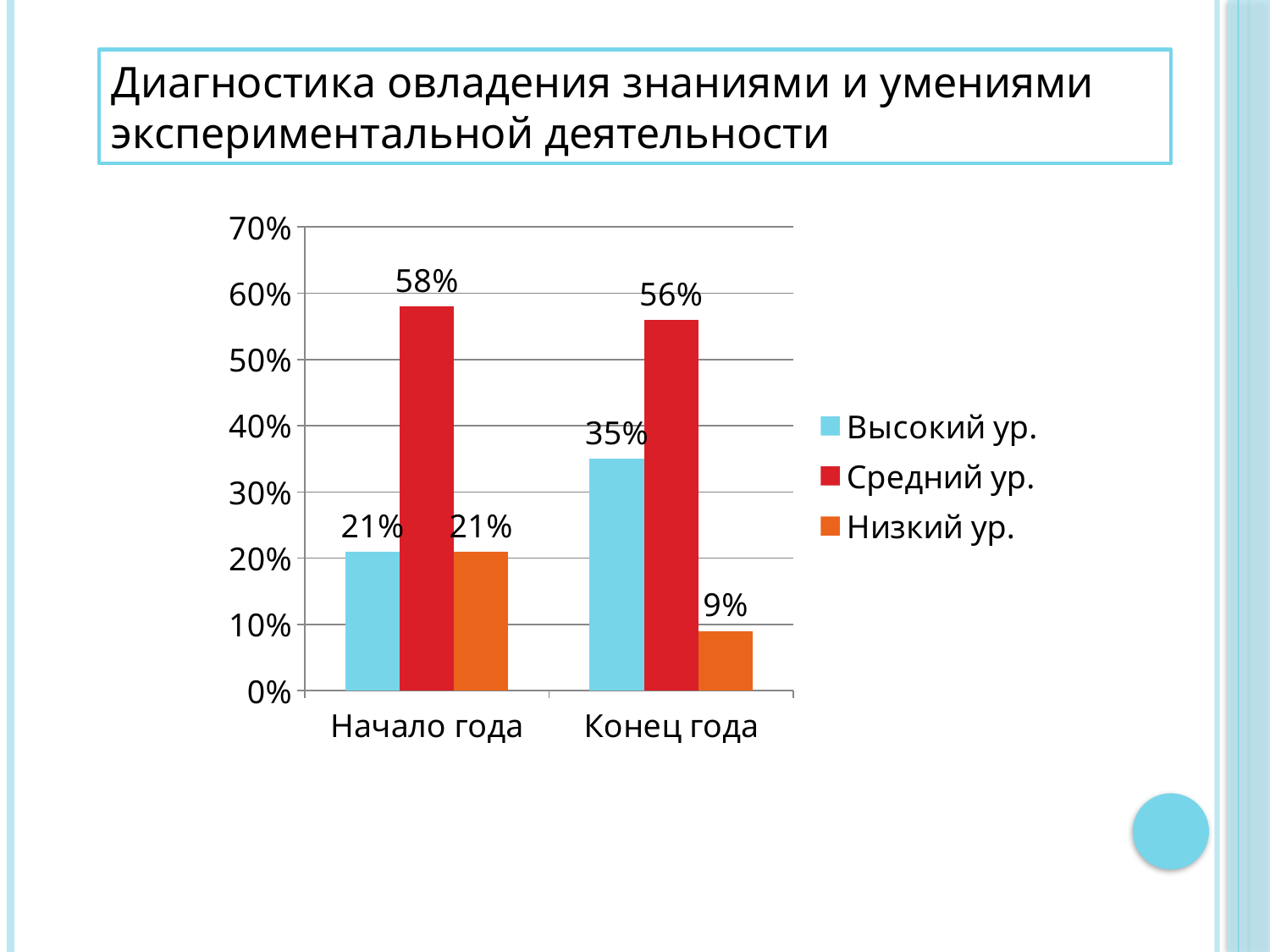
What kind of chart is shown on the slide? bar chart What is the value for Средний ур. at Конец года? 56% What is the value for Высокий ур. at Начало года? 21% How many categories are shown on the x axis? 2 Does the value for Низкий ур. rise or fall from Начало года to Конец года? fall What is the difference between the Высокий ур. values at Конец года and Начало года? 14% How many series does the legend list? 3 Which series has the lowest value at Конец года? Низкий ур. Which is larger: Низкий ур. at Начало года or Низкий ур. at Конец года? Начало года What is the value for Низкий ур. at Конец года? 9% Is the value for Высокий ур. at Конец года greater or less than 30%? greater Which series has the highest value at Начало года? Средний ур.